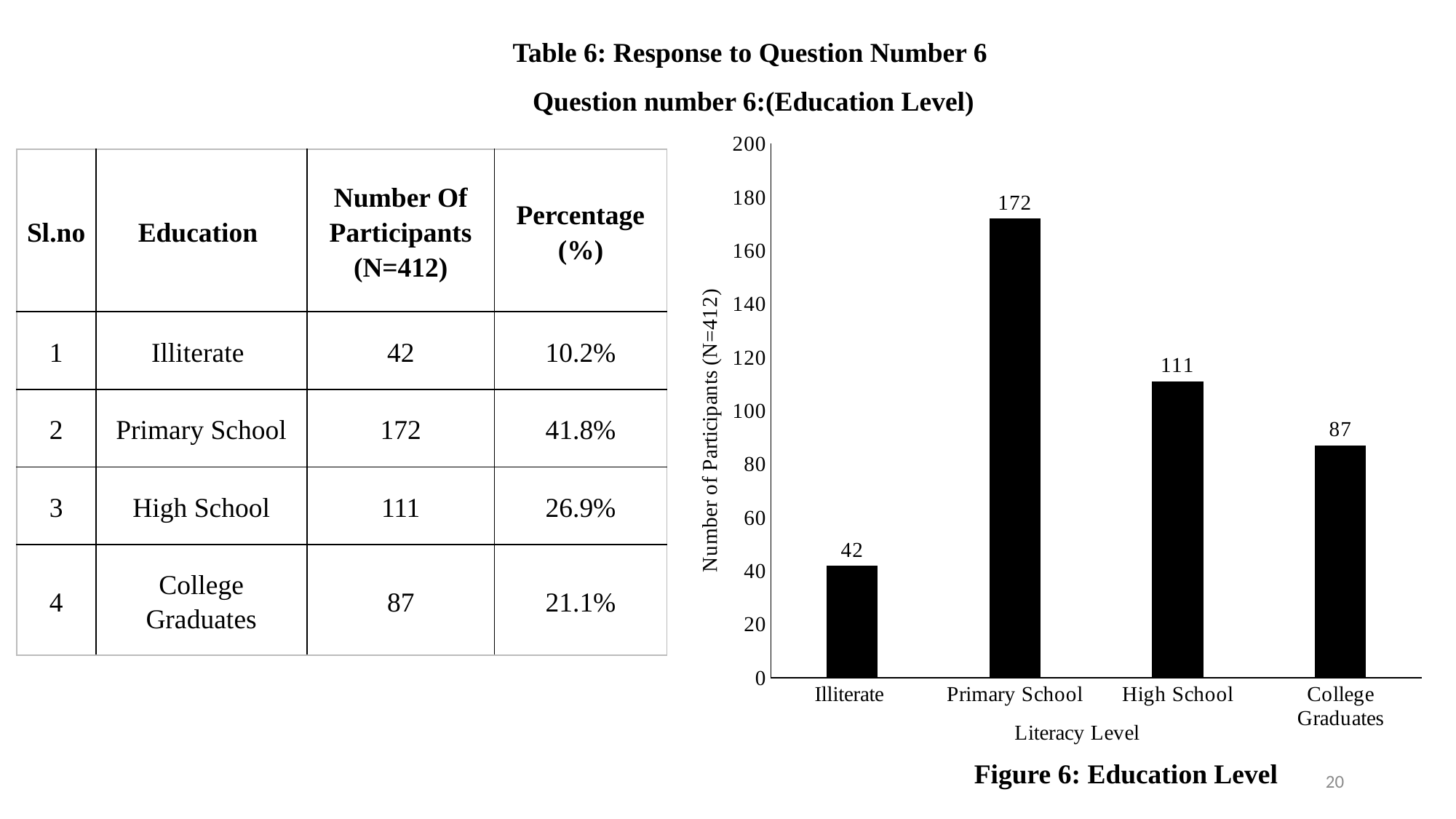
What is the number of participants for Primary School in the chart? 172 What is the title of the figure shown on the slide? Figure 6: Education Level What is the difference in number of participants between Primary School and High School? 61 How many literacy level categories are shown in the chart? 4 Which literacy level has the highest number of participants in the chart? Primary School Is the value for High School greater or less than 100? greater Which has more participants, High School or College Graduates? High School What is the label of the x axis of the chart? Literacy Level What is the number of participants for College Graduates in the chart? 87 What is the number of participants for Illiterate in the chart? 42 What kind of chart is Figure 6? bar chart Which literacy level has the lowest number of participants in the chart? Illiterate